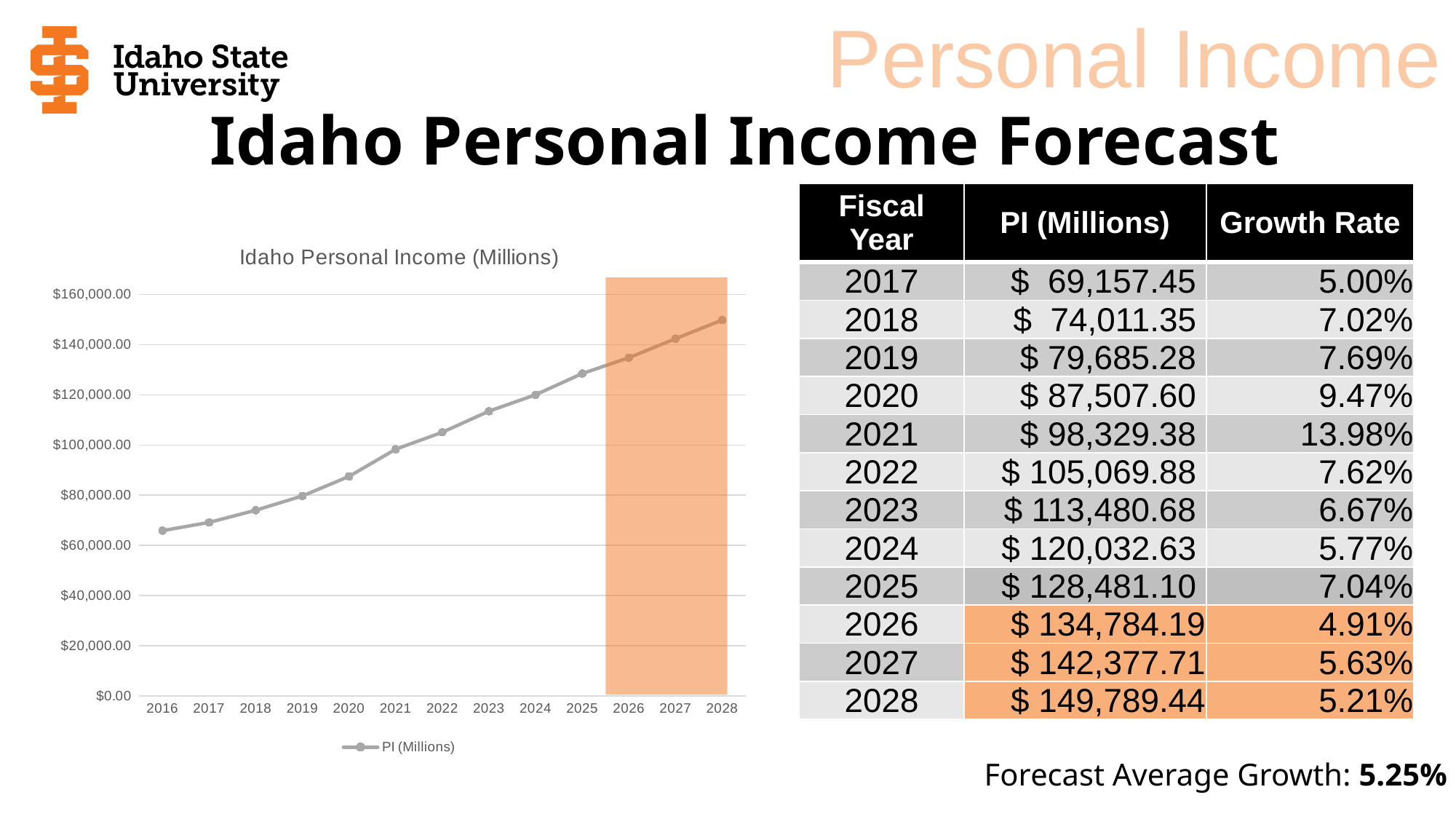
What is the title of the chart? Idaho Personal Income (Millions) How many years are plotted along the x axis of the chart? 13 Is the plotted value for 2024 greater or less than $140,000.00? less According to the slide, what is the personal income (PI, millions) for 2028? $ 149,789.44 Which year has the highest plotted personal income value? 2028 According to the slide, what is the difference in PI (Millions) between 2028 and 2027? $ 7,411.73 Which years on the chart are covered by the orange shaded forecast region? 2026, 2027 and 2028 How many series does the chart legend list? 1 Do the plotted personal income values rise or fall from 2016 to 2028? rise Which year has the lowest plotted personal income value? 2016 Is the plotted value for 2016 greater or less than $60,000.00? greater What kind of chart is shown on the slide? line chart